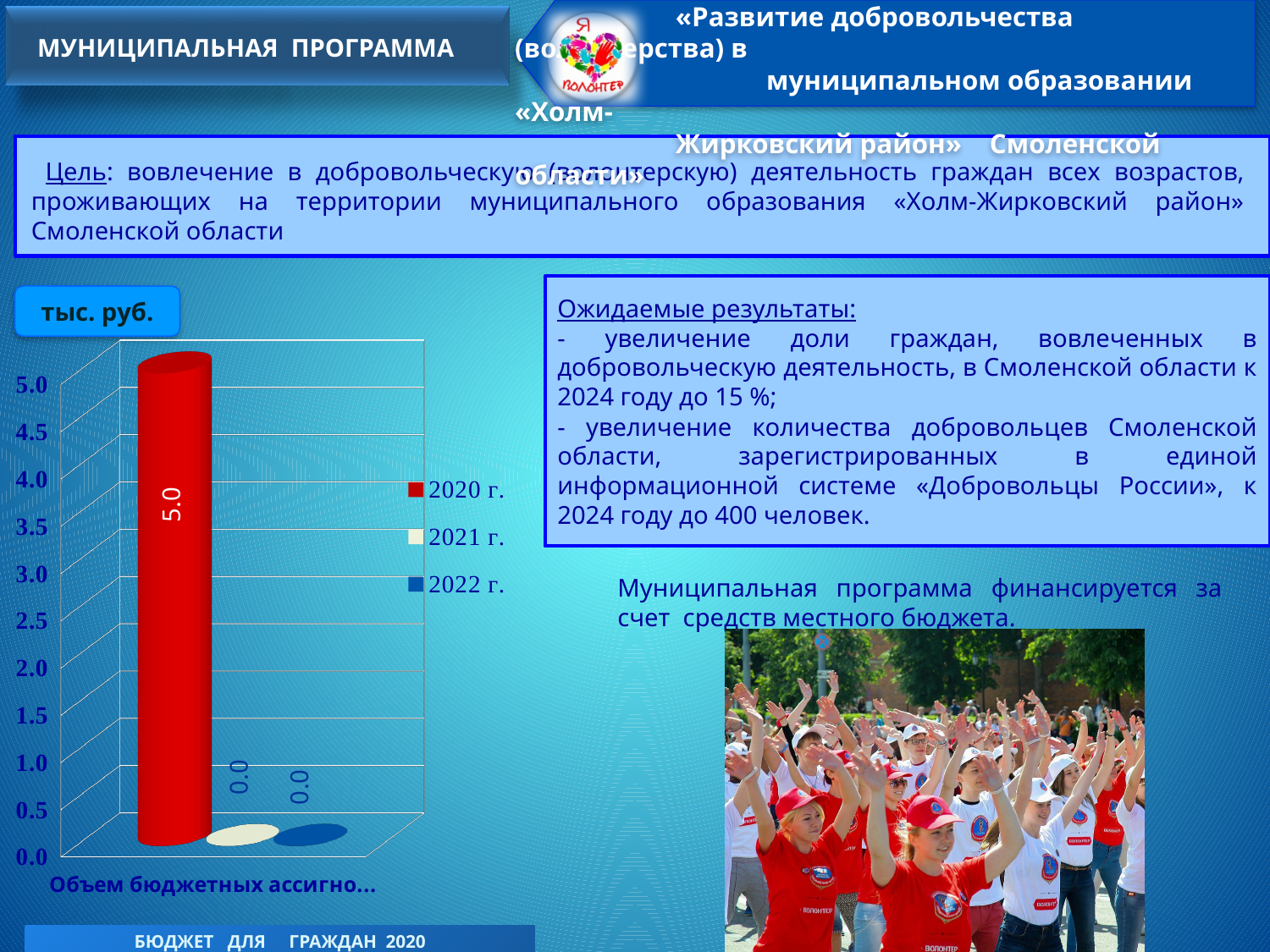
Do the values fall or rise from 2020 г. to 2022 г.? fall What colour is the bar for 2020 г.? red Which is larger, the value for 2020 г. or the value for 2022 г.? 2020 г. What is the value for 2022 г. on the chart? 0.0 What is the value for 2020 г. on the chart? 5.0 How many series does the chart legend list? 3 Is the value for 2020 г. greater or less than 4.0? greater Which year has the highest value on the chart? 2020 г. What unit is shown in the label above the chart? тыс. руб. What kind of chart is shown on the slide? bar chart What is the value for 2021 г. on the chart? 0.0 What is the difference between the values for 2020 г. and 2021 г.? 5.0